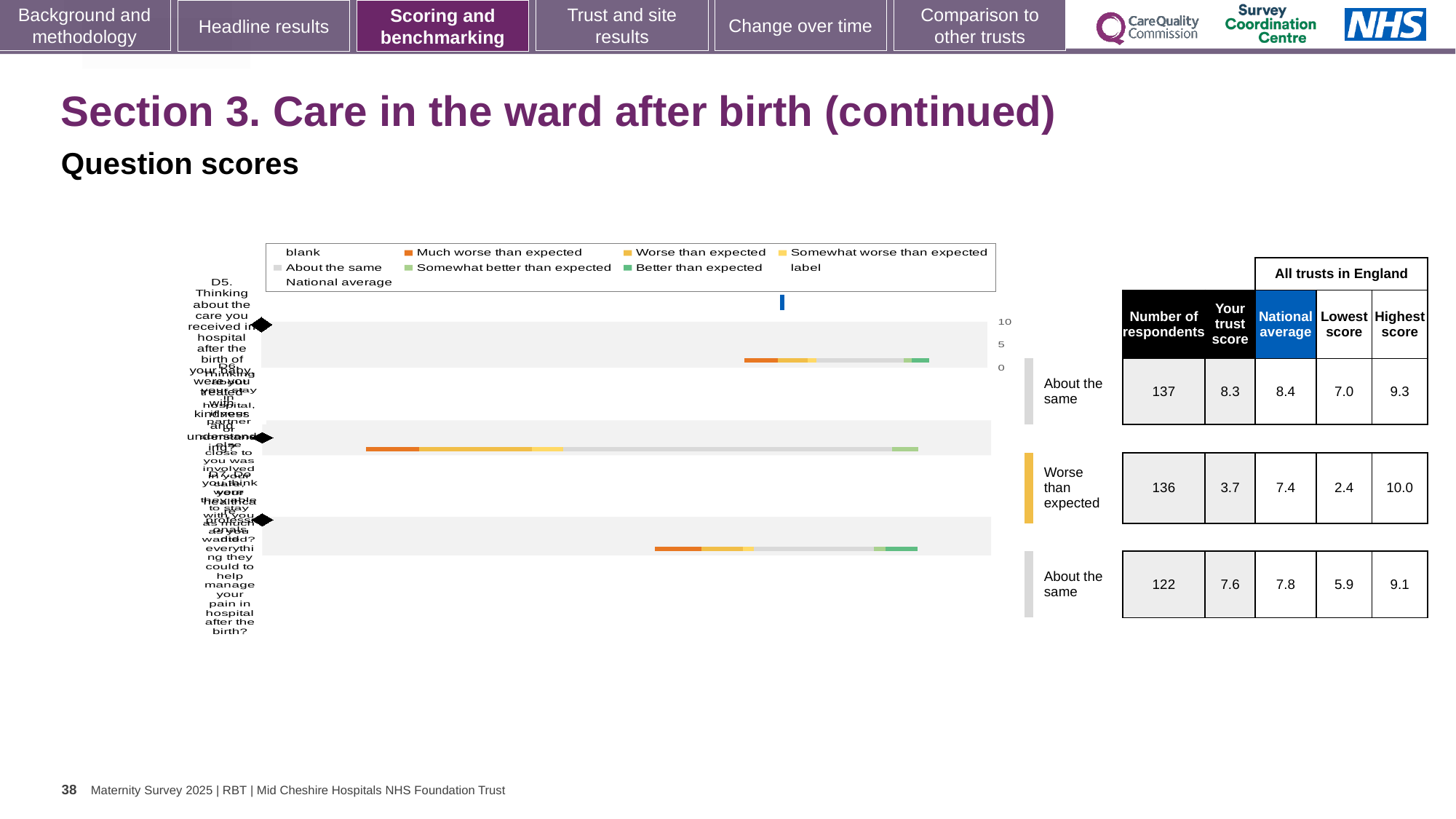
How many question rows are plotted in the chart? 3 For the first question row, which is larger: the trust score or the national average? the national average What is the difference between the national average and the trust score for the second question row? 3.7 Which question row has the highest number of respondents? the first row What is the national average for the third question row (bottom row)? 7.8 Is the trust score for the second question row greater or less than 5? less What kind of chart is shown on the slide? bar chart What is the number of respondents for the first question row (top row)? 137 What is the trust score for the second question row, the one rated 'Worse than expected'? 3.7 What benchmark category is shown for the third question row? About the same What is the highest score among all trusts in England for the second question row? 10.0 Which question row has the lowest trust score? the second row (Worse than expected)